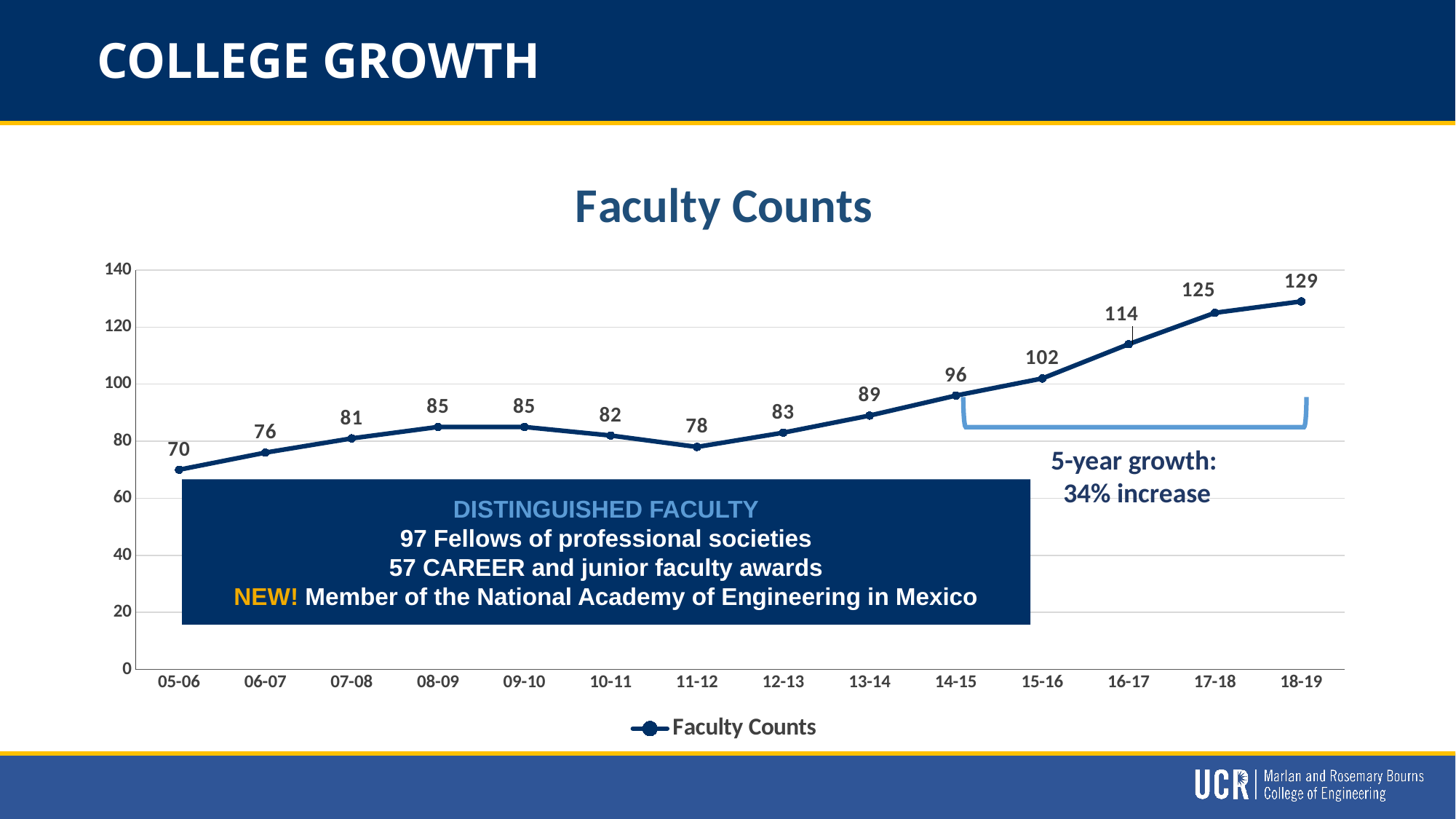
How many academic years are plotted on the chart? 14 What is the faculty count for 11-12? 78 Is the faculty count for 16-17 greater or less than 100? greater What is the faculty count for 05-06? 70 Which year has the highest faculty count? 18-19 What is the faculty count for 18-19? 129 What is the difference in faculty count between 14-15 and 18-19? 33 What kind of chart is shown? line chart Which is larger, the faculty count for 10-11 or for 11-12? 10-11 Which year has the lowest faculty count? 05-06 What is the difference in faculty count between 18-19 and 05-06? 59 What is the title of the chart? Faculty Counts